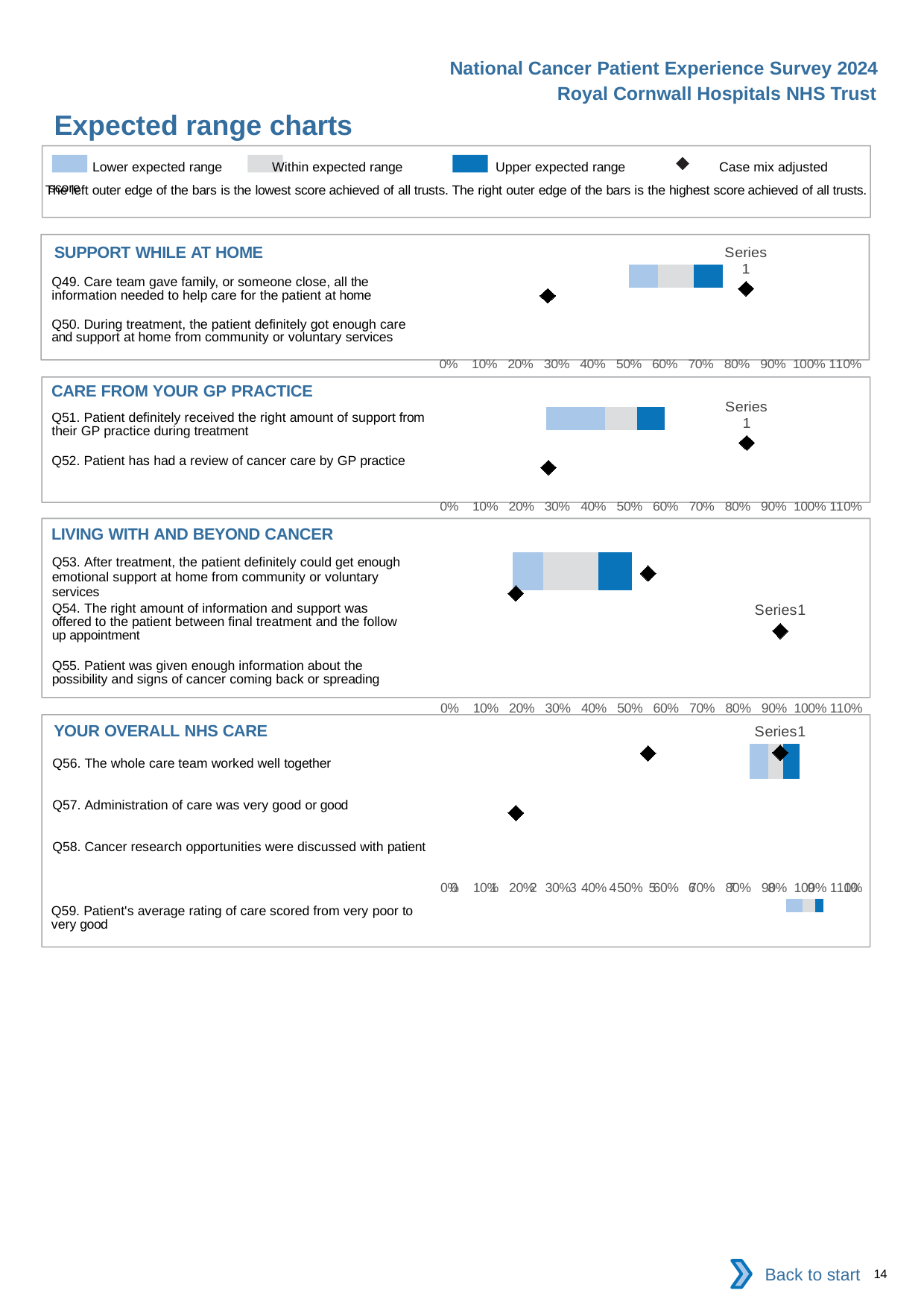
In the LIVING WITH AND BEYOND CANCER chart, is the left edge of the expected range bar greater or less than 10%? greater How many questions are listed in the SUPPORT WHILE AT HOME chart? 2 How many questions are listed in the YOUR OVERALL NHS CARE chart? 4 What kind of chart is used in the SUPPORT WHILE AT HOME section? bar chart Which legend entry is represented by a black diamond marker? Case mix adjusted score In the SUPPORT WHILE AT HOME chart, is the left edge of the expected range bar greater or less than 40%? greater How many chart sections are shown on the slide? 4 In the CARE FROM YOUR GP PRACTICE chart, is the right edge of the expected range bar greater or less than 70%? less Which legend entry is shown in dark blue? Upper expected range How many entries does the legend at the top of the slide list? 4